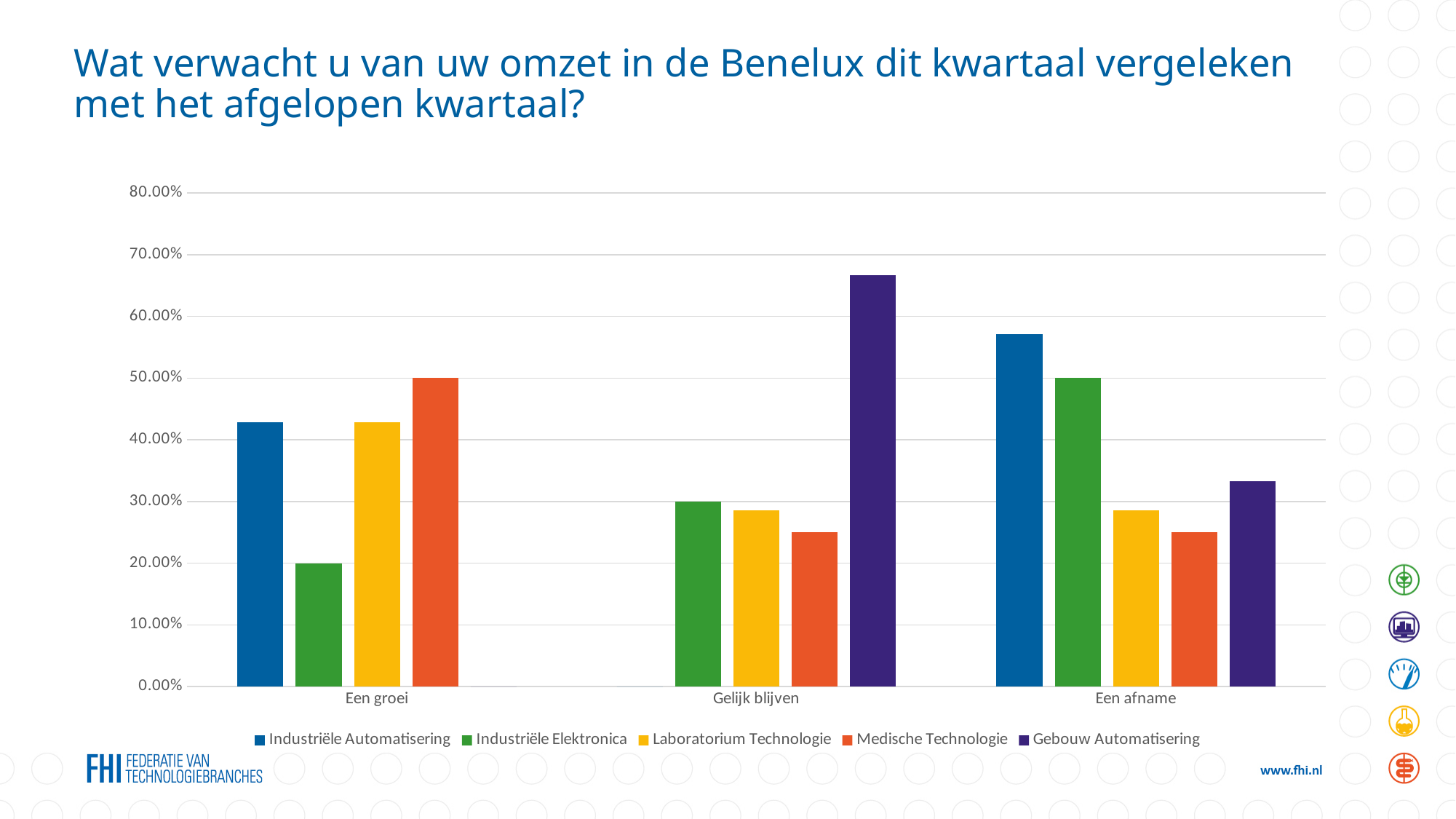
Is the value for Gebouw Automatisering in 'Gelijk blijven' greater or less than 60.00%? greater What is the value for Industriële Elektronica in the 'Gelijk blijven' category? 30.00% Is the value for Industriële Automatisering in 'Een afname' greater or less than 50.00%? greater In the 'Een afname' category, which is larger: Industriële Automatisering or Gebouw Automatisering? Industriële Automatisering Which series is shown in orange-red in the legend? Medische Technologie How many categories are shown on the x axis? 3 What is the value for Industriële Elektronica in the 'Een groei' category? 20.00% Which series has the lowest value in the 'Een groei' category among the plotted bars? Industriële Elektronica How many series does the legend list? 5 What is the value for Medische Technologie in the 'Een groei' category? 50.00% What kind of chart is shown on the slide? bar chart Which series has the highest value in the 'Gelijk blijven' category? Gebouw Automatisering